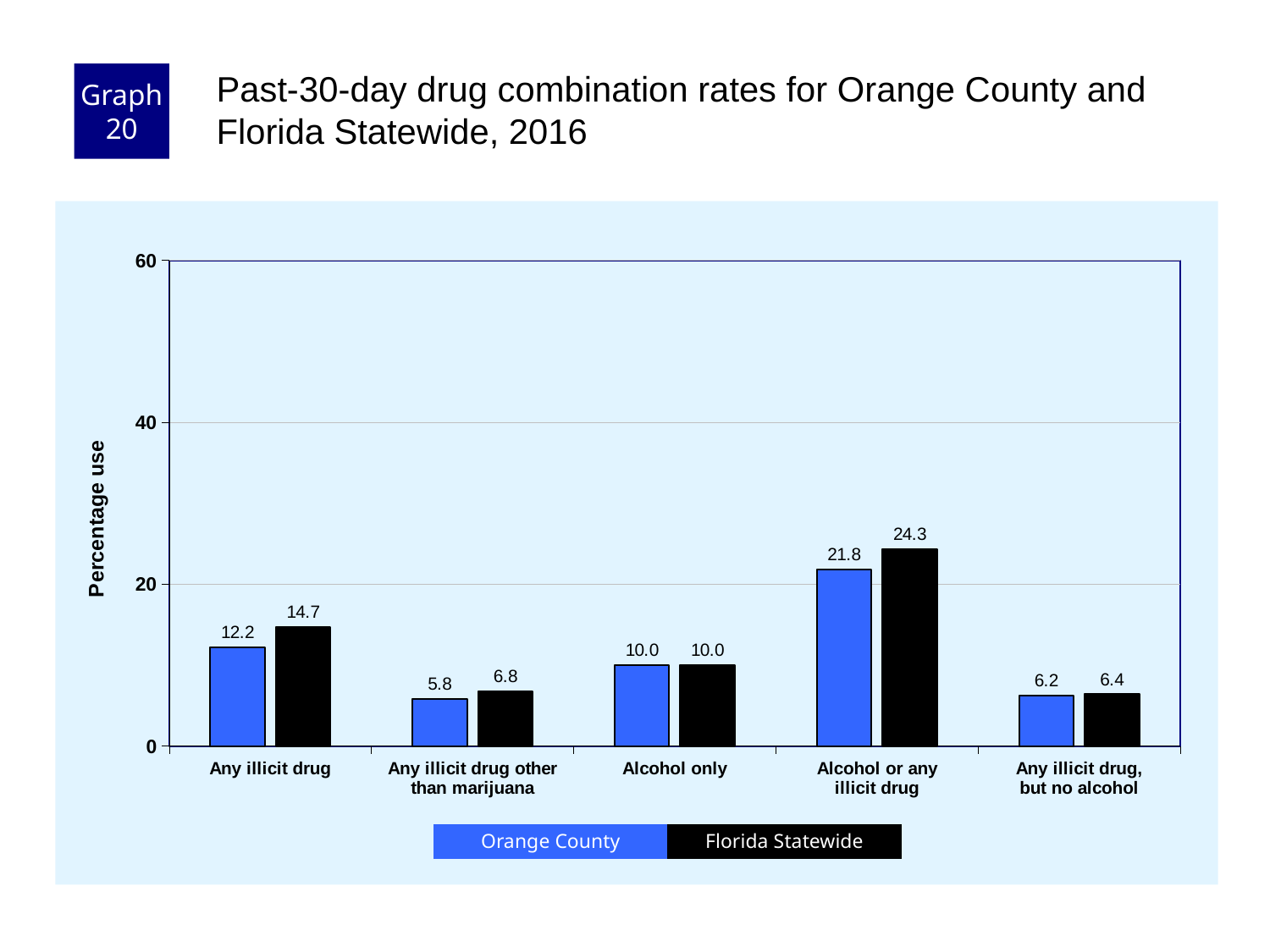
Which category has the highest Orange County value? Alcohol or any illicit drug What is the Orange County value for Any illicit drug? 12.2 What kind of chart is shown on the slide? bar chart Which category has the lowest Florida Statewide value? Any illicit drug, but no alcohol What is the label of the y axis? Percentage use Which is larger for Alcohol or any illicit drug: Orange County or Florida Statewide? Florida Statewide How many series does the legend list? 2 What is the difference between the Florida Statewide and Orange County values for Any illicit drug? 2.5 How many categories are shown on the x axis? 5 What is the Florida Statewide value for Any illicit drug other than marijuana? 6.8 What is the Florida Statewide value for Alcohol or any illicit drug? 24.3 Is the Florida Statewide value for Alcohol or any illicit drug greater or less than 20? greater